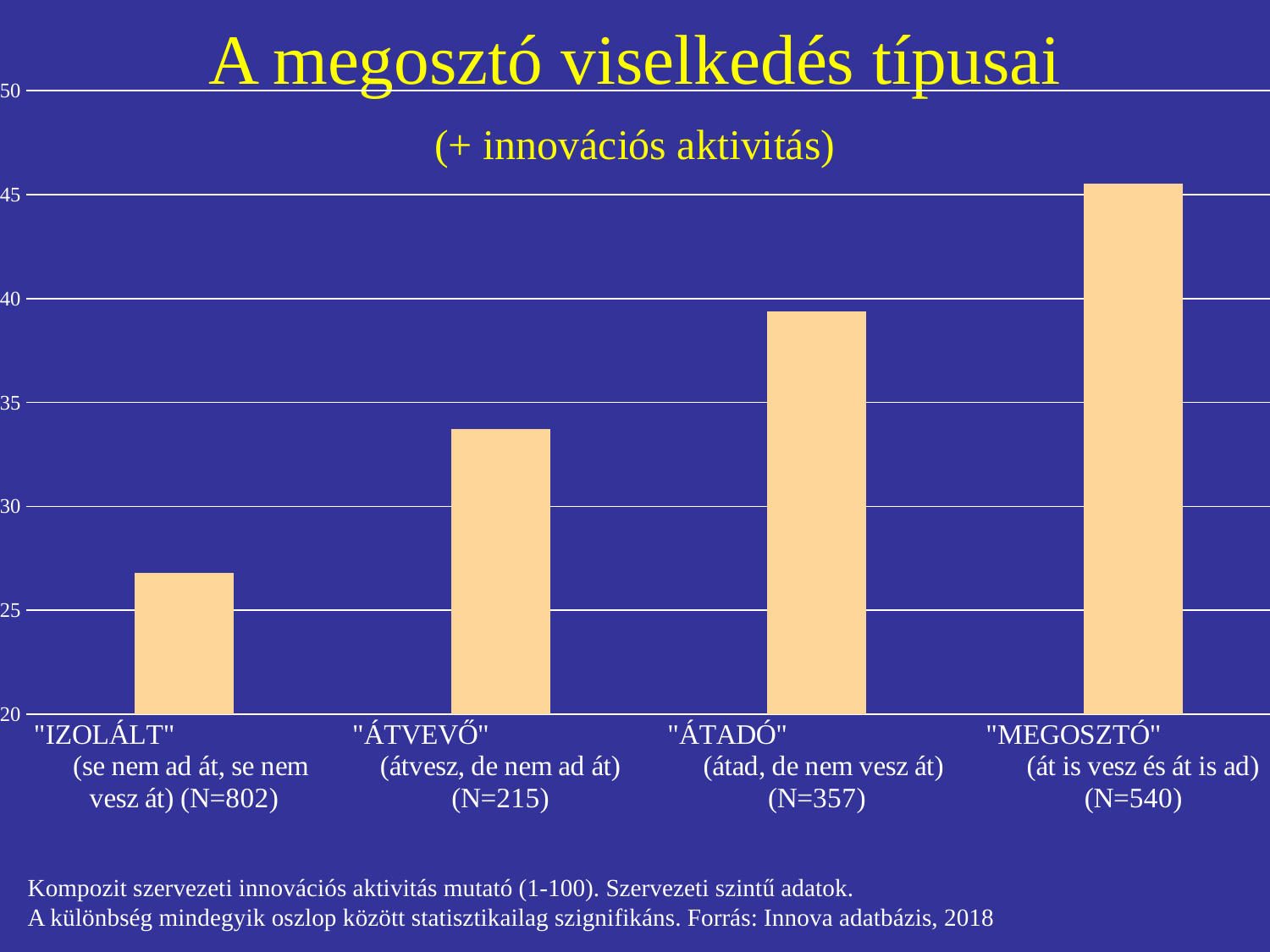
Which category has the lowest bar? "IZOLÁLT" Is the value for "IZOLÁLT" greater or less than 25? greater How many bars (categories) does the chart show? 4 Do the bar values rise or fall from left to right across the categories? rise Is the value for "IZOLÁLT" greater or less than 30? less What is the title of the chart? A megosztó viselkedés típusai (+ innovációs aktivitás) Is the value for "ÁTVEVŐ" greater or less than 35? less Which is larger, the value for "ÁTVEVŐ" or the value for "ÁTADÓ"? "ÁTADÓ" What kind of chart is shown on the slide? bar chart Which category has the highest bar? "MEGOSZTÓ"